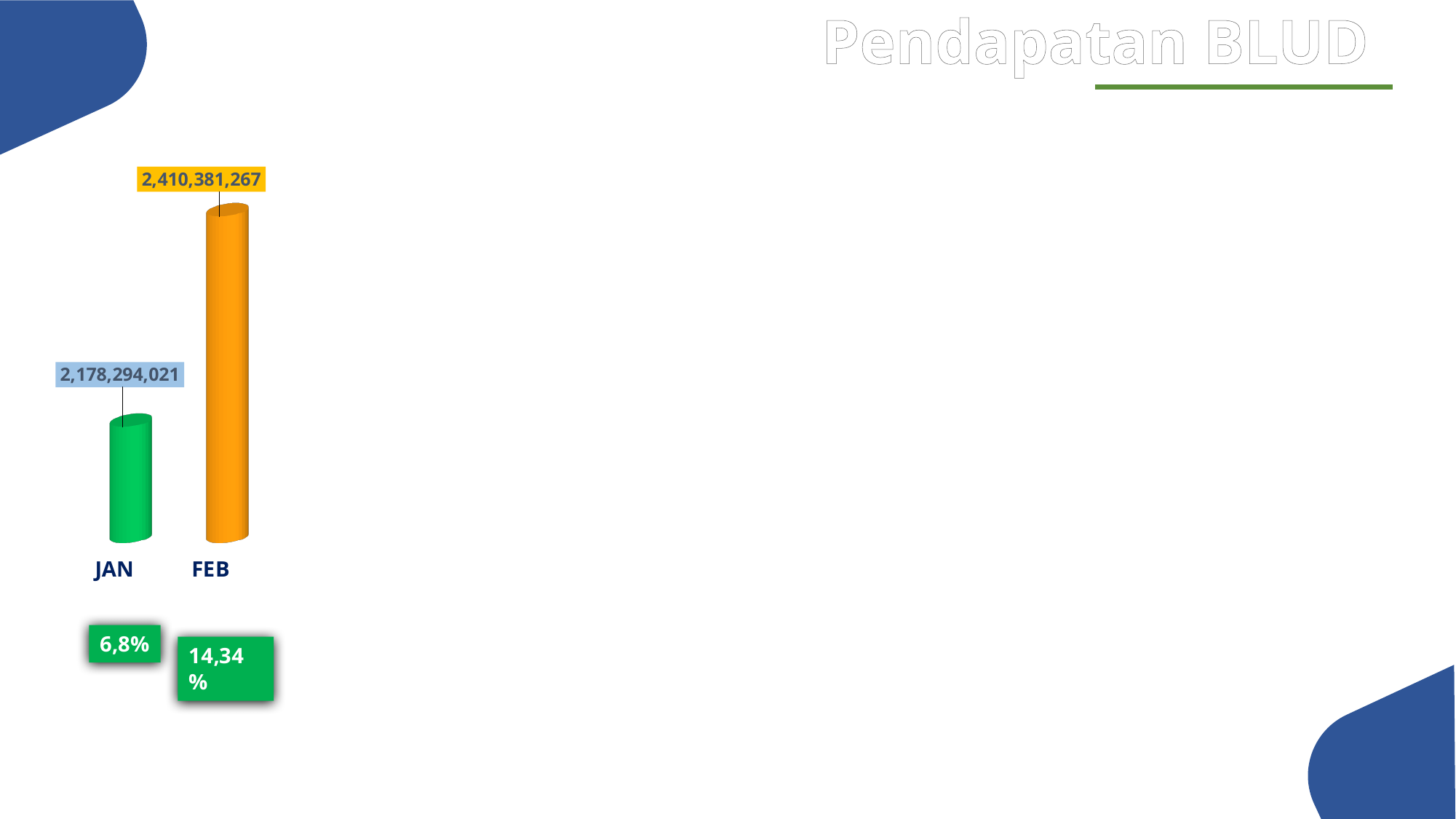
What kind of chart is shown on the slide? Bar chart Do the values rise or fall from JAN to FEB? Rise How many categories are shown in the chart? 2 Which month has the lowest value? JAN What is the value for FEB? 2,410,381,267 What is the difference between the FEB and JAN values? 232,087,246 What is the title of the slide containing the chart? Pendapatan BLUD Which is larger, the value for JAN or the value for FEB? FEB What colour is the FEB bar? Orange Which month has the highest value? FEB What is the value for JAN? 2,178,294,021